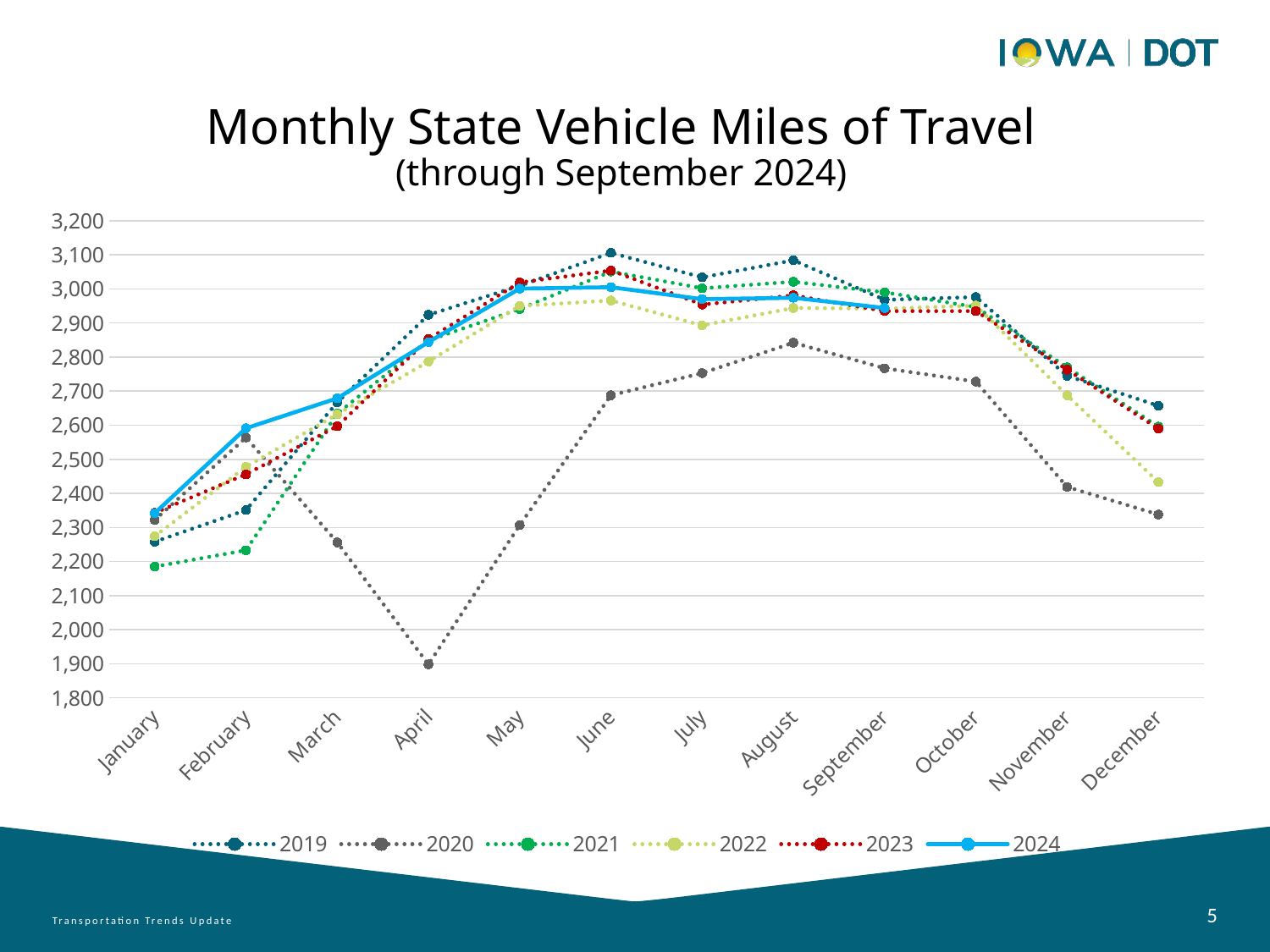
Which year's series has the lowest value in April? 2020 Is the 2020 value for April greater or less than 2,000? less What kind of chart is shown on the slide? line chart Does the 2020 series rise or fall from March to April? fall Which year's series has the highest value in June? 2019 Is the 2019 value for June greater or less than 3,000? greater Which is larger in August, the 2019 value or the 2020 value? 2019 Which year's series is drawn as a solid line rather than a dotted line? 2024 Is the 2020 value for December greater or less than 2,400? less How many series does the legend list? 6 How many months are shown along the x axis? 12